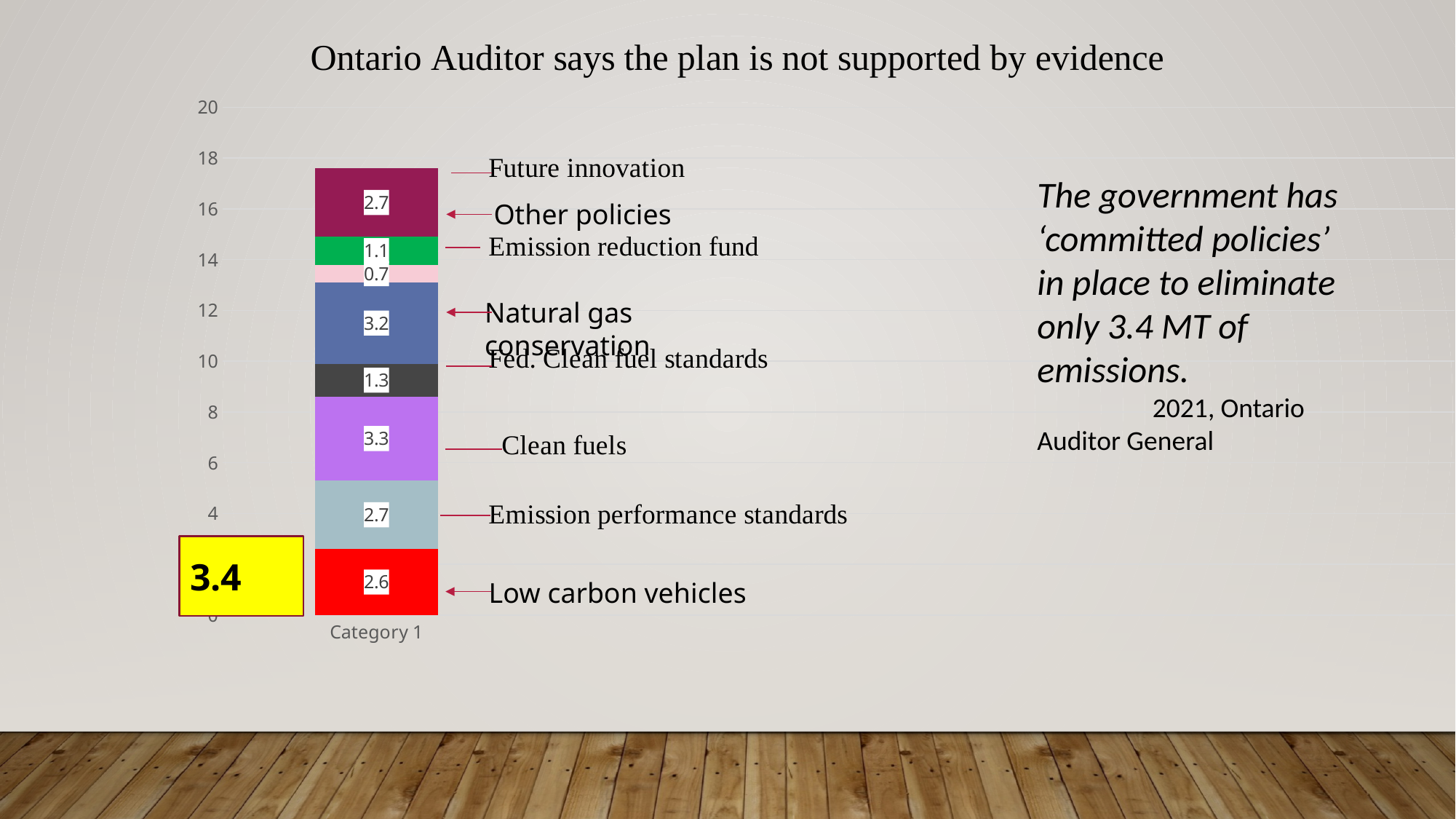
What is the total of all the segment values in the stacked bar? 17.6 What is the smallest segment value printed on the stacked bar? 0.7 Which is larger, the Clean fuels segment or the Low carbon vehicles segment? Clean fuels What kind of chart is shown on the slide? Stacked bar chart What value is shown for the Natural gas conservation segment? 3.2 What value is shown for the Clean fuels segment? 3.3 How many segments make up the stacked bar? 8 What is the label on the category axis below the stacked bar? Category 1 What value is shown for the Low carbon vehicles segment of the stacked bar? 2.6 What value is shown for the Emission performance standards segment? 2.7 What value is shown for the Emission reduction fund segment? 1.1 What is the difference between the Clean fuels value and the Low carbon vehicles value? 0.7